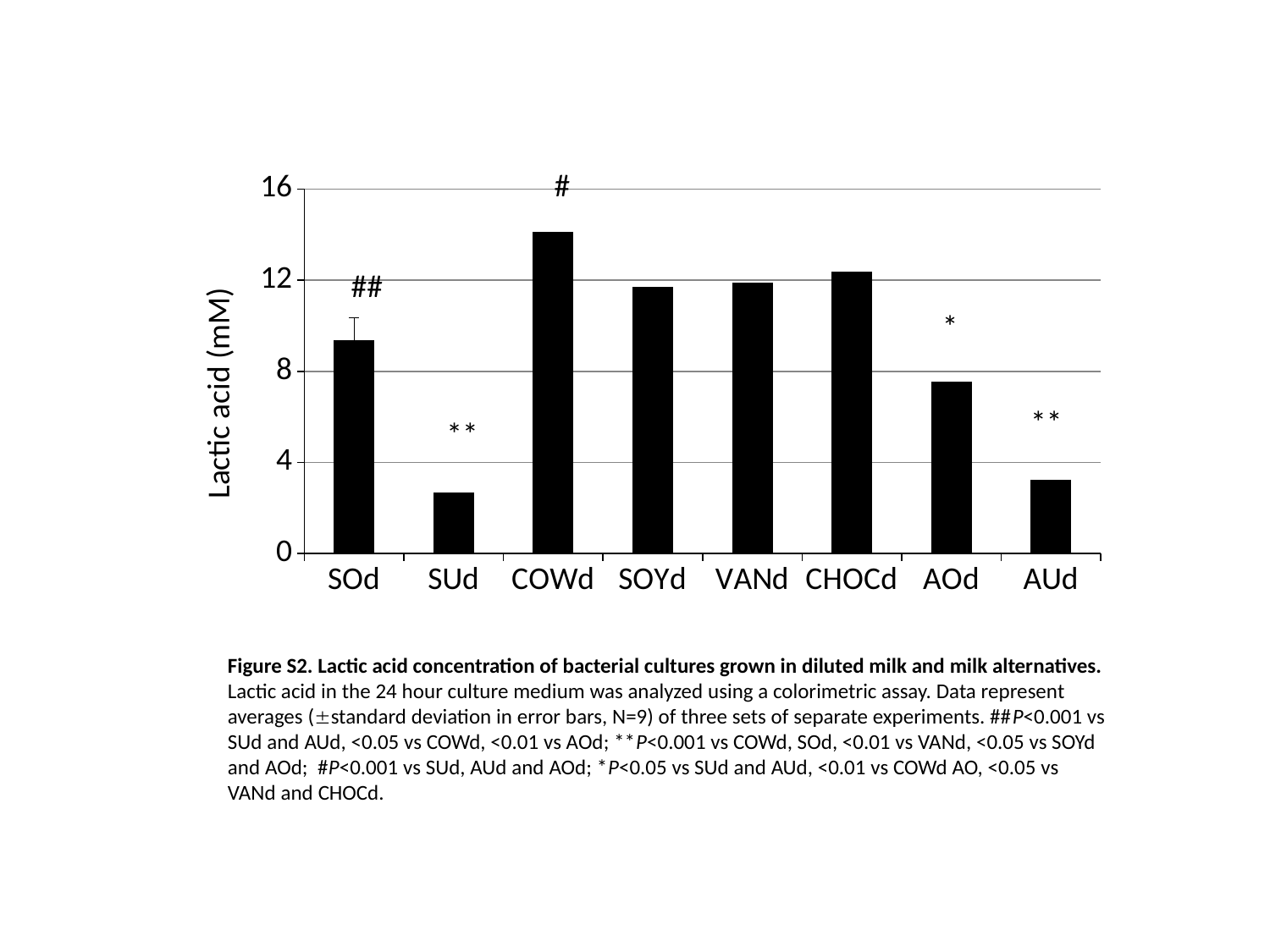
Is the value for SOYd greater or less than 12? less Which is larger, the value for CHOCd or the value for AUd? CHOCd Which is larger, the value for SOd or the value for AOd? SOd Is the value for SOd greater or less than 8? greater What is the label of the y axis? Lactic acid (mM) Is the value for AUd greater or less than 4? less What kind of chart is shown on the slide? bar chart Which category has the highest lactic acid concentration? COWd How many categories are plotted on the x axis? 8